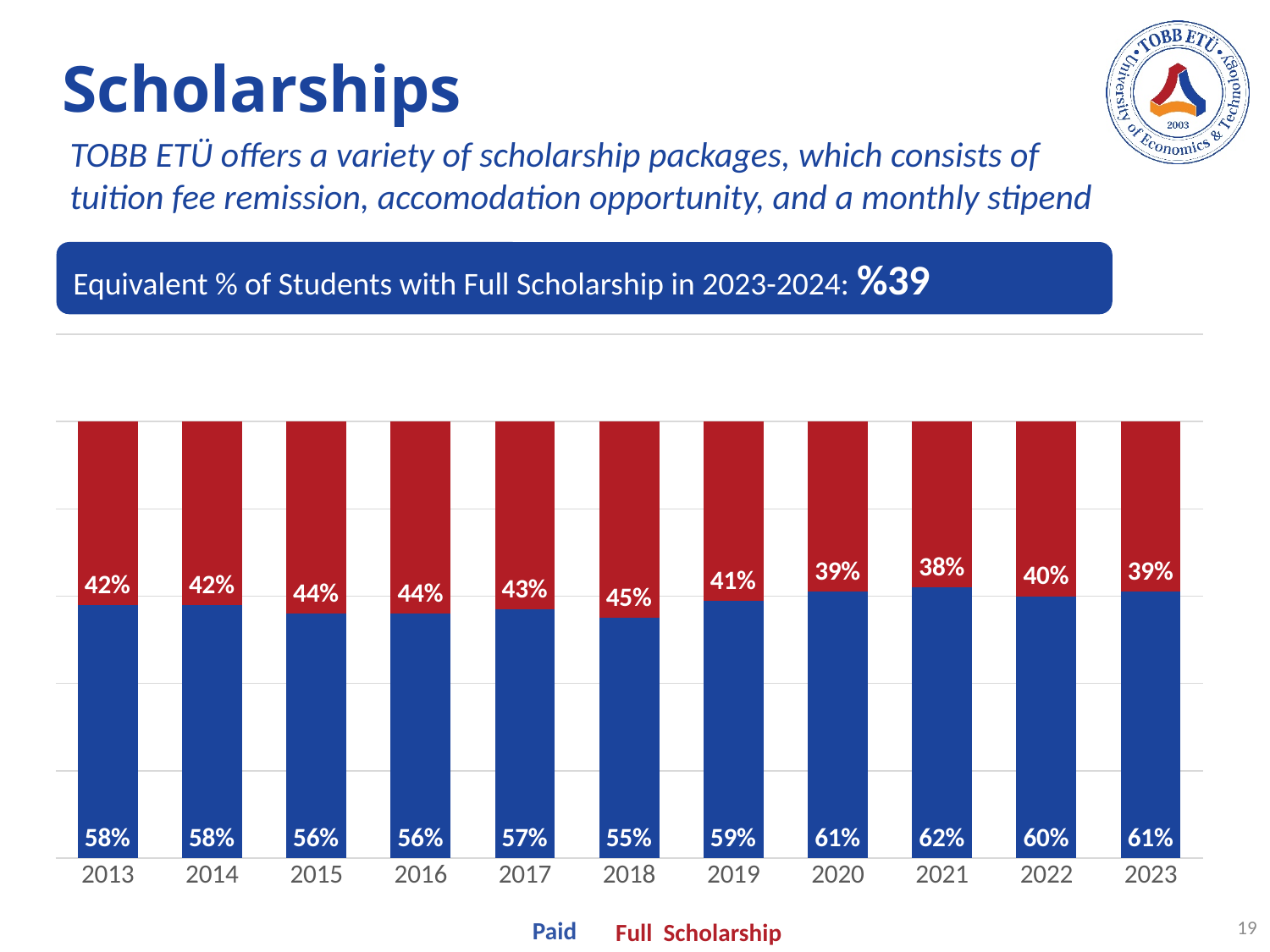
What is the difference between the Paid value in 2021 and the Paid value in 2018? 7% How many years are shown on the x axis? 11 Which year has the highest Paid percentage? 2021 Which year has the lowest Full Scholarship percentage? 2021 What is the Paid value for 2021? 62% What is the total of the stacked bar for 2019? 100% Which is larger, the Full Scholarship value for 2015 or for 2020? 2015 Which year has the highest Full Scholarship percentage? 2018 How many series does the legend list? 2 What kind of chart is shown on the slide? Stacked bar chart What is the Full Scholarship value for 2023? 39% What is the Full Scholarship value for 2018? 45%